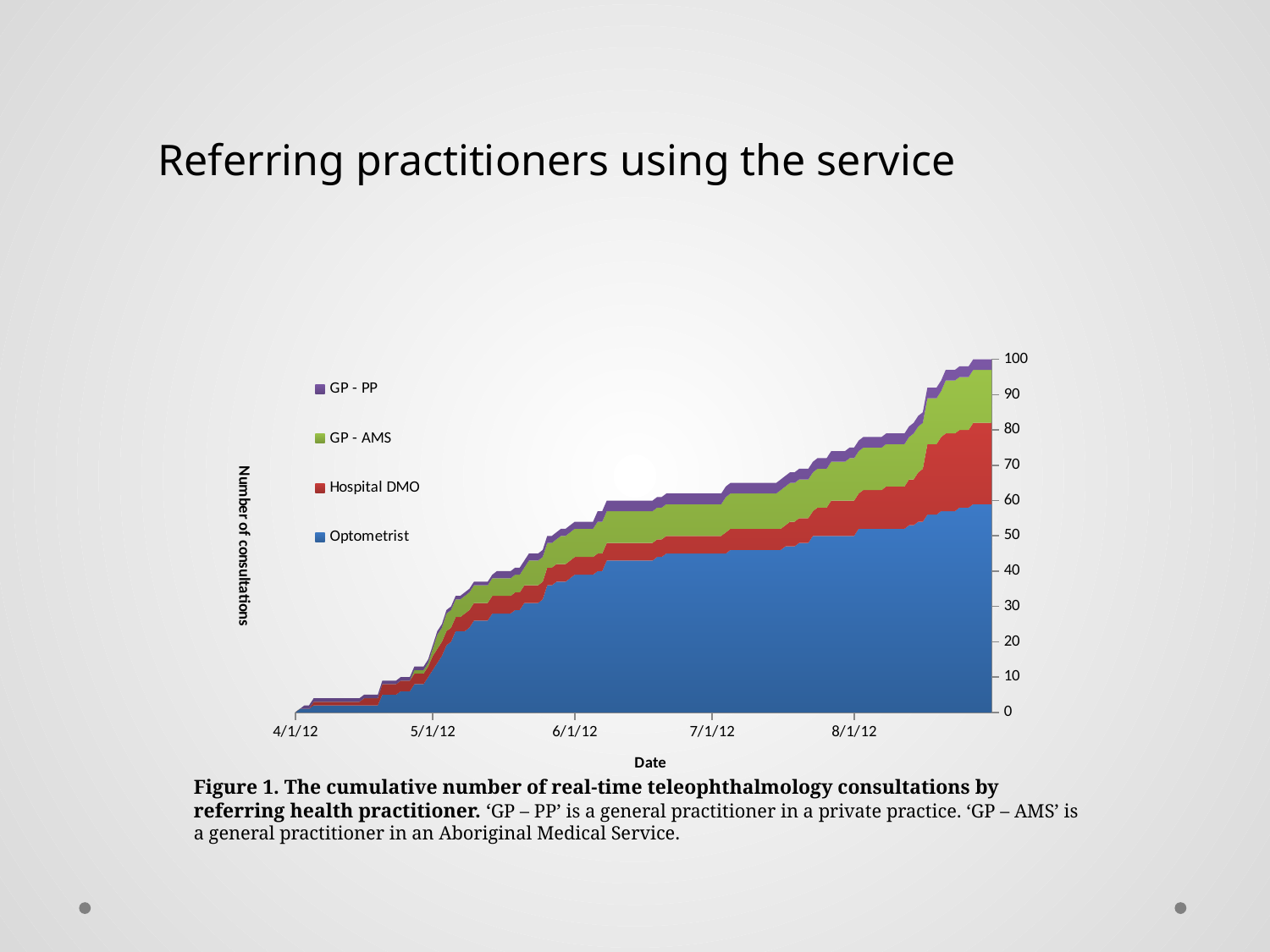
What kind of chart is shown on the slide? Stacked area chart Which series contributes the smallest number of consultations at the end of the period? GP - PP Is the cumulative number of Optometrist consultations at 7/1/12 greater or less than 50? less What is the title of the vertical axis? Number of consultations At the end of the period, which series has more consultations: Hospital DMO or GP - AMS? Hospital DMO Is the total cumulative number of consultations at 8/1/12 greater or less than 70? greater Which series does the legend list first (at the top)? GP - PP Do the cumulative consultation values rise or fall along the x axis from 4/1/12 onward? Rise Is the total cumulative number of consultations at the end of the period greater or less than 90? greater Which series contributes the largest number of consultations at the end of the period? Optometrist How many series does the legend list? 4